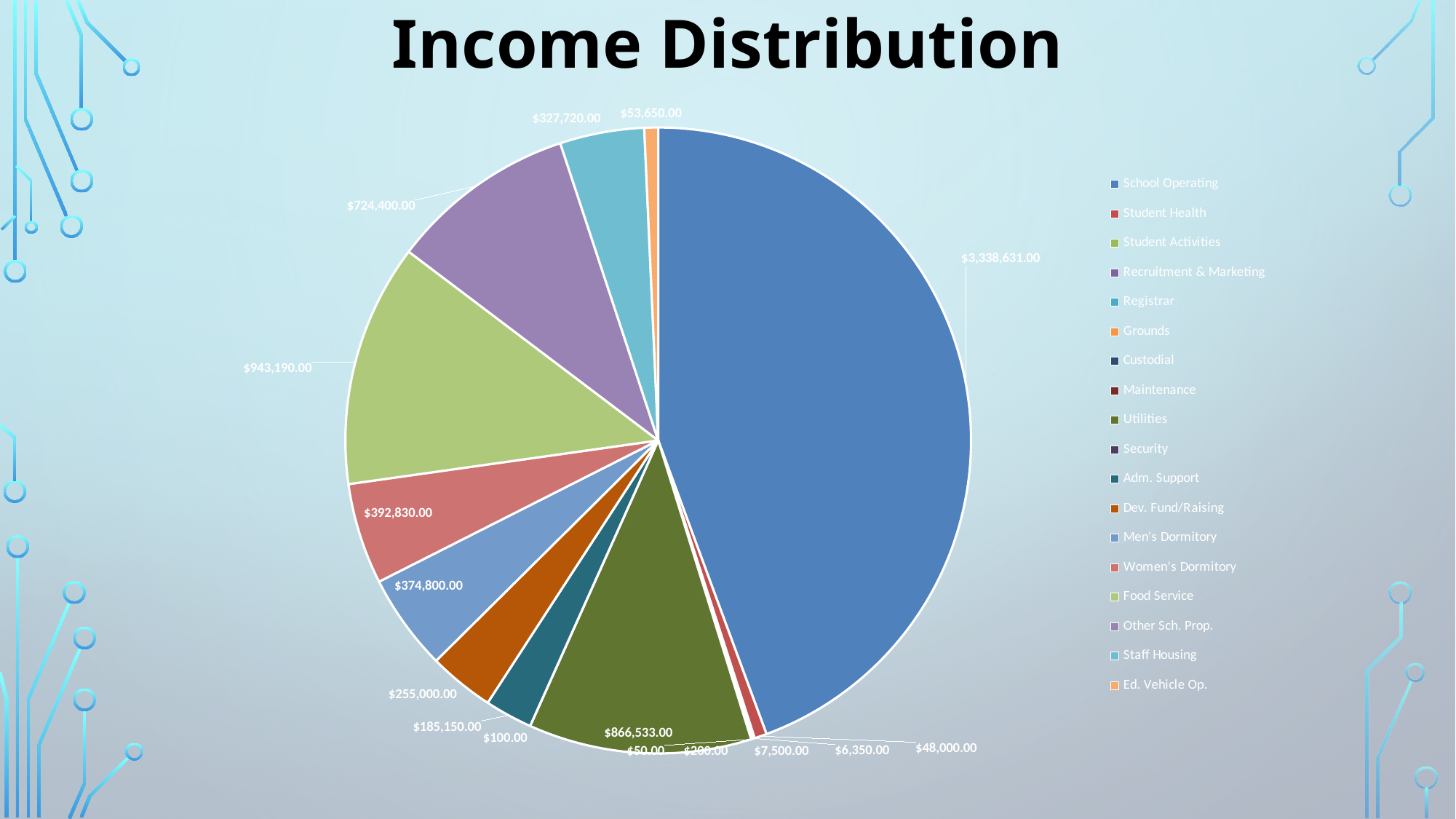
What is the value shown for Staff Housing? $327,720.00 What is the value shown for Utilities? $866,533.00 What is the value shown for Food Service? $943,190.00 Which is larger, Food Service or Other Sch. Prop.? Food Service What is the value shown for School Operating? $3,338,631.00 What type of chart is shown on the slide? pie chart What is the smallest value labelled on the pie? $50.00 What is the value shown for Other Sch. Prop.? $724,400.00 How many categories does the legend list? 18 What is the difference between the Food Service value and the Utilities value? $76,657.00 Which category has the largest slice of the pie? School Operating What is the title of the chart? Income Distribution